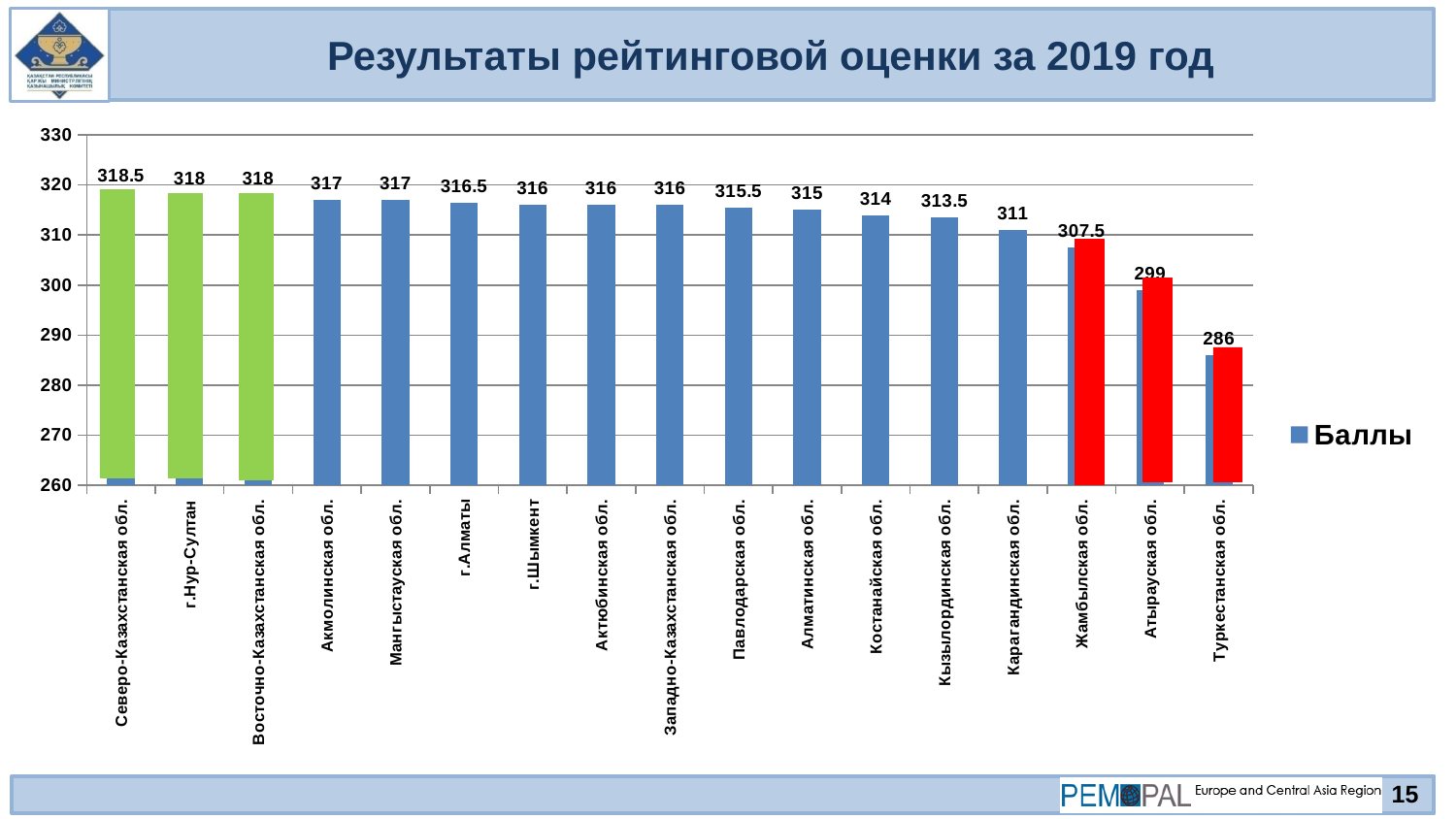
What is the value for Туркестанская обл.? 286 What is the value for Северо-Казахстанская обл.? 318.5 Which is larger, the value for Жамбылская обл. or the value for Атырауская обл.? Жамбылская обл. What is the value for Карагандинская обл.? 311 What type of chart is shown on the slide? Bar chart Which category has the highest value? Северо-Казахстанская обл. How many series does the legend list? 1 What is the title of the chart on the slide? Результаты рейтинговой оценки за 2019 год What is the difference between the values for Северо-Казахстанская обл. and Туркестанская обл.? 32.5 What is the value for г.Алматы? 316.5 Which category has the lowest value? Туркестанская обл. How many categories are shown on the x axis? 17